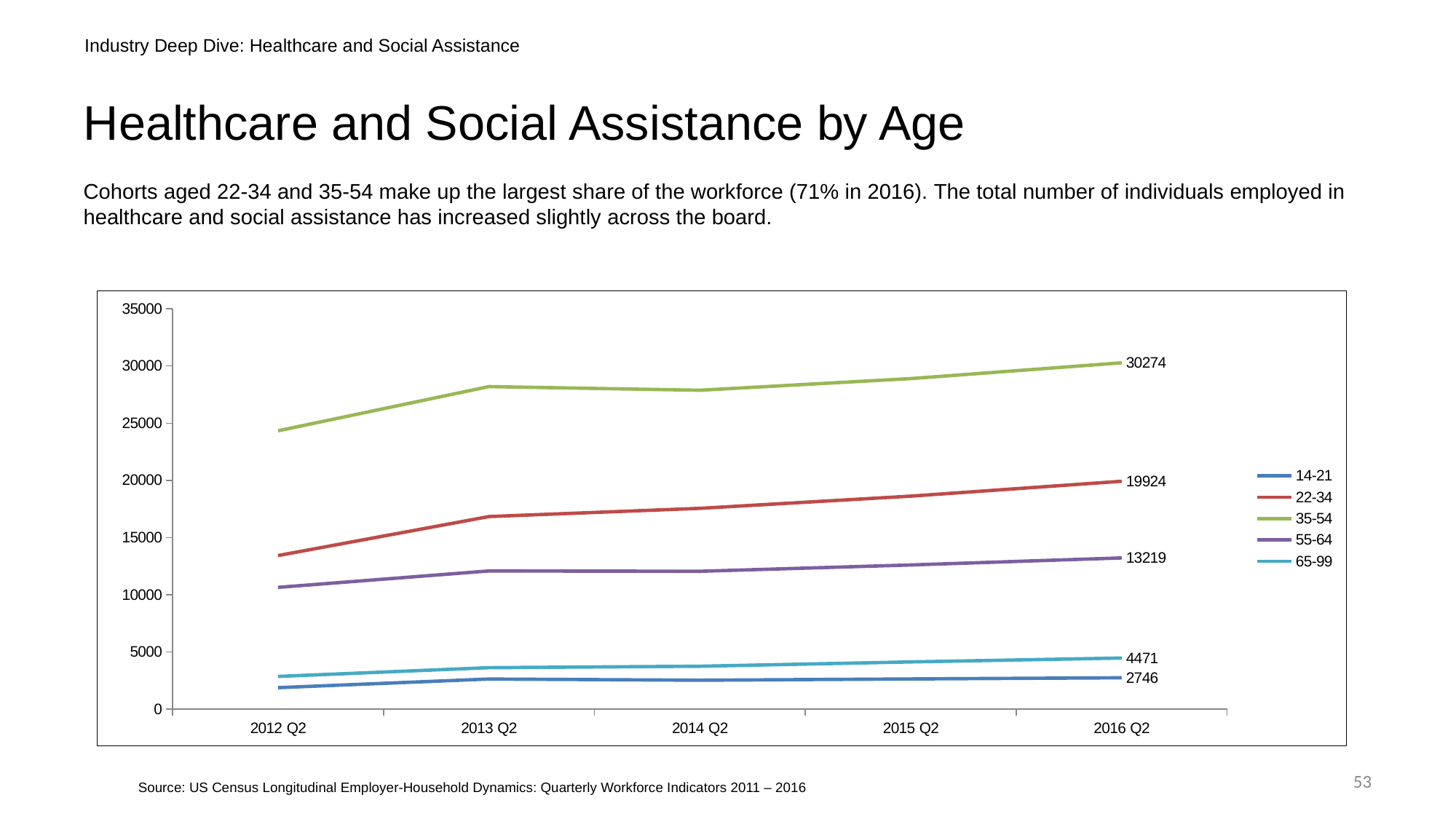
Is the value for the 35-54 series at 2012 Q2 greater or less than 20000? greater What is the difference between the 35-54 and 22-34 values at 2016 Q2? 10350 What is the value for the 35-54 series at 2016 Q2? 30274 How many series does the legend list? 5 Which age cohort has the highest value at 2016 Q2? 35-54 Which age cohort has the lowest value at 2016 Q2? 14-21 Does the 22-34 series rise or fall from 2012 Q2 to 2016 Q2? rise What kind of chart is shown on the slide? line chart Which is larger at 2016 Q2, the 65-99 value or the 14-21 value? 65-99 What is the value for the 14-21 series at 2016 Q2? 2746 What is the value for the 55-64 series at 2016 Q2? 13219 What is the value for the 22-34 series at 2016 Q2? 19924